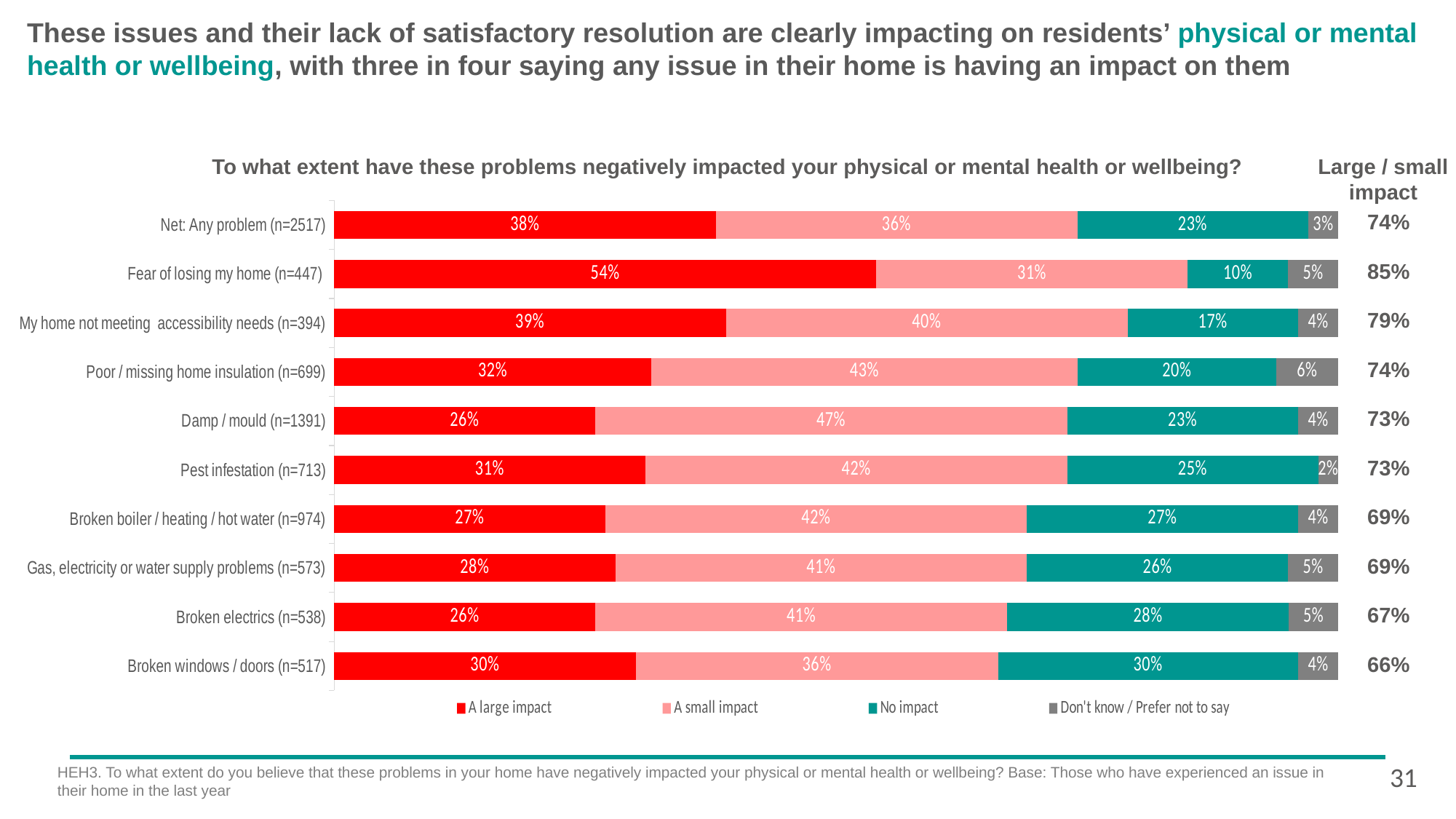
What percentage of respondents with 'Damp / mould' reported a small impact? 47% How many series does the legend list? 4 Which has a larger 'No impact' value: 'Broken electrics' or 'Pest infestation'? Broken electrics Which series is shown in dark teal in the legend? No impact What kind of chart is shown on the slide? Stacked bar chart What is the combined 'Large / small impact' figure for 'My home not meeting accessibility needs'? 79% What is the difference between the 'A large impact' values for 'Fear of losing my home' and 'Damp / mould'? 28% Which category has the lowest 'Large / small impact' combined figure? Broken windows / doors (n=517) What percentage of respondents with 'Broken windows / doors' reported no impact? 30% What percentage of respondents with 'Fear of losing my home' reported a large impact? 54% How many categories are shown on the chart? 10 Which category has the highest 'A large impact' value? Fear of losing my home (n=447)